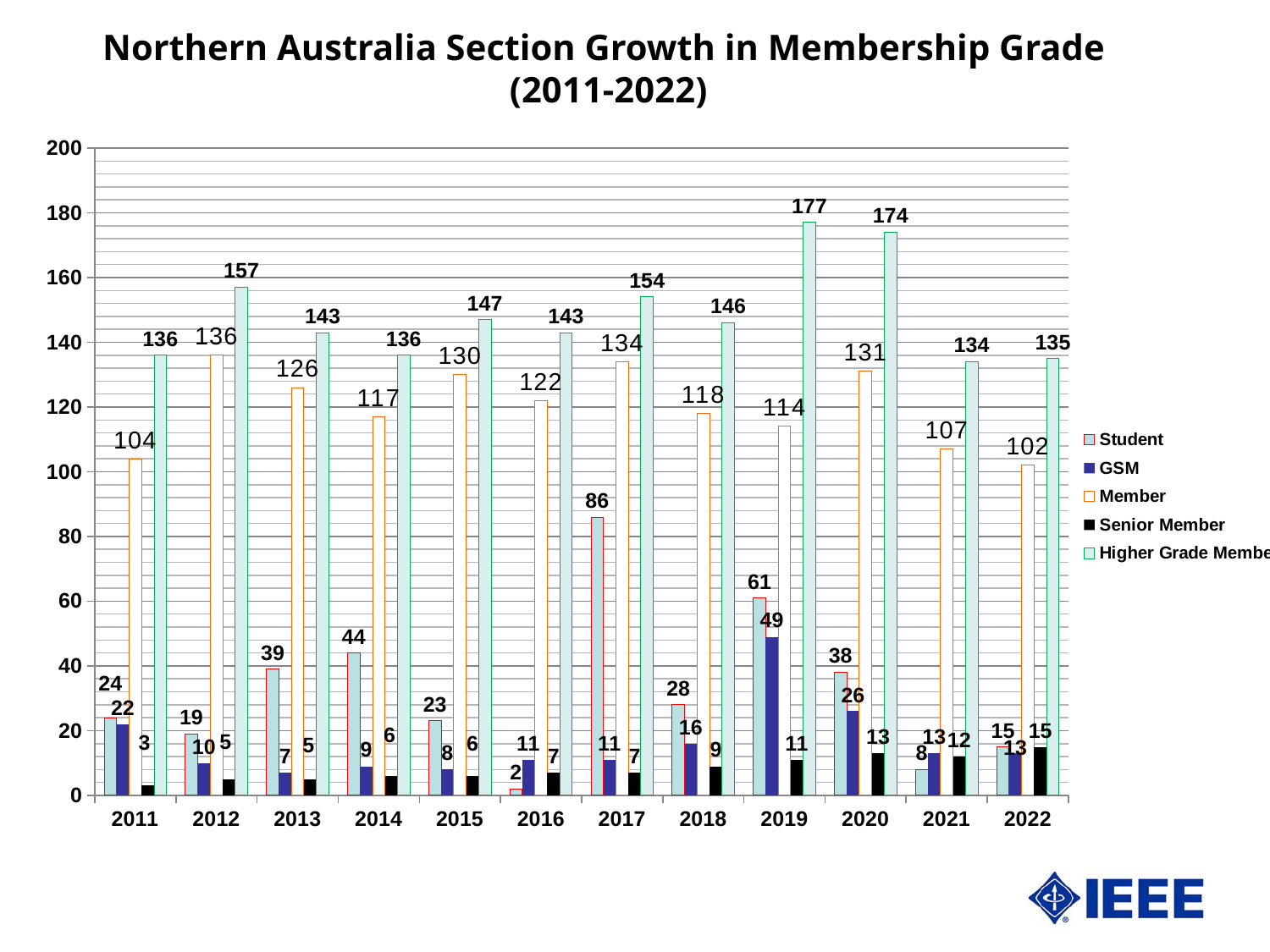
What type of chart is shown on the slide? Bar chart What is the difference between the Higher Grade Member values for 2019 and 2020? 3 Is the Member value for 2022 greater or less than 120? less How many years are shown on the x axis? 12 What is the Member value for 2011? 104 How many series does the legend list? 5 What is the Higher Grade Member value for 2019? 177 Which is larger, the GSM value for 2019 or the GSM value for 2020? 2019 In which year is the Student value lowest? 2016 In which year is the Higher Grade Member value highest? 2019 What is the Student value for 2017? 86 Do the Senior Member values generally rise or fall from 2011 to 2022? Rise